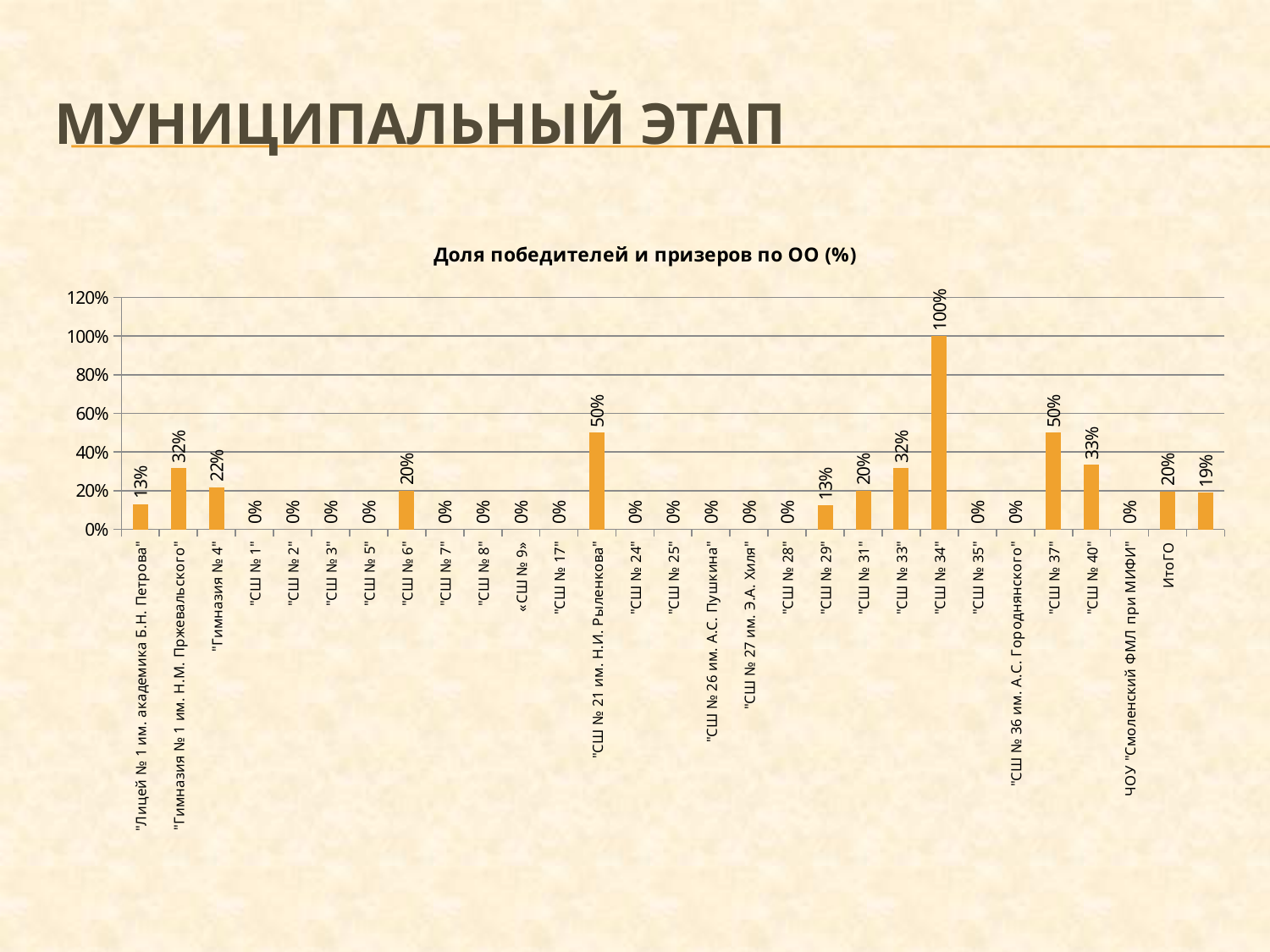
What is the value for "Гимназия № 4"? 22% What is the value for "СШ № 21 им. Н.И. Рыленкова"? 50% What is the difference between the values for "Гимназия № 1 им. Н.М. Пржевальского" and "Лицей № 1 им. академика Б.Н. Петрова"? 19% Which category has the highest value? "СШ № 34" What is the value for Итого? 20% Is the value for "СШ № 37" greater or less than 40%? greater What is the value for "СШ № 40"? 33% What is the difference between the values for "СШ № 34" and "СШ № 37"? 50% What is the value for "СШ № 34"? 100% Which is larger, the value for "СШ № 33" or the value for "СШ № 31"? "СШ № 33" What type of chart is shown on the slide? bar chart What is the title of the chart? Доля победителей и призеров по ОО (%)